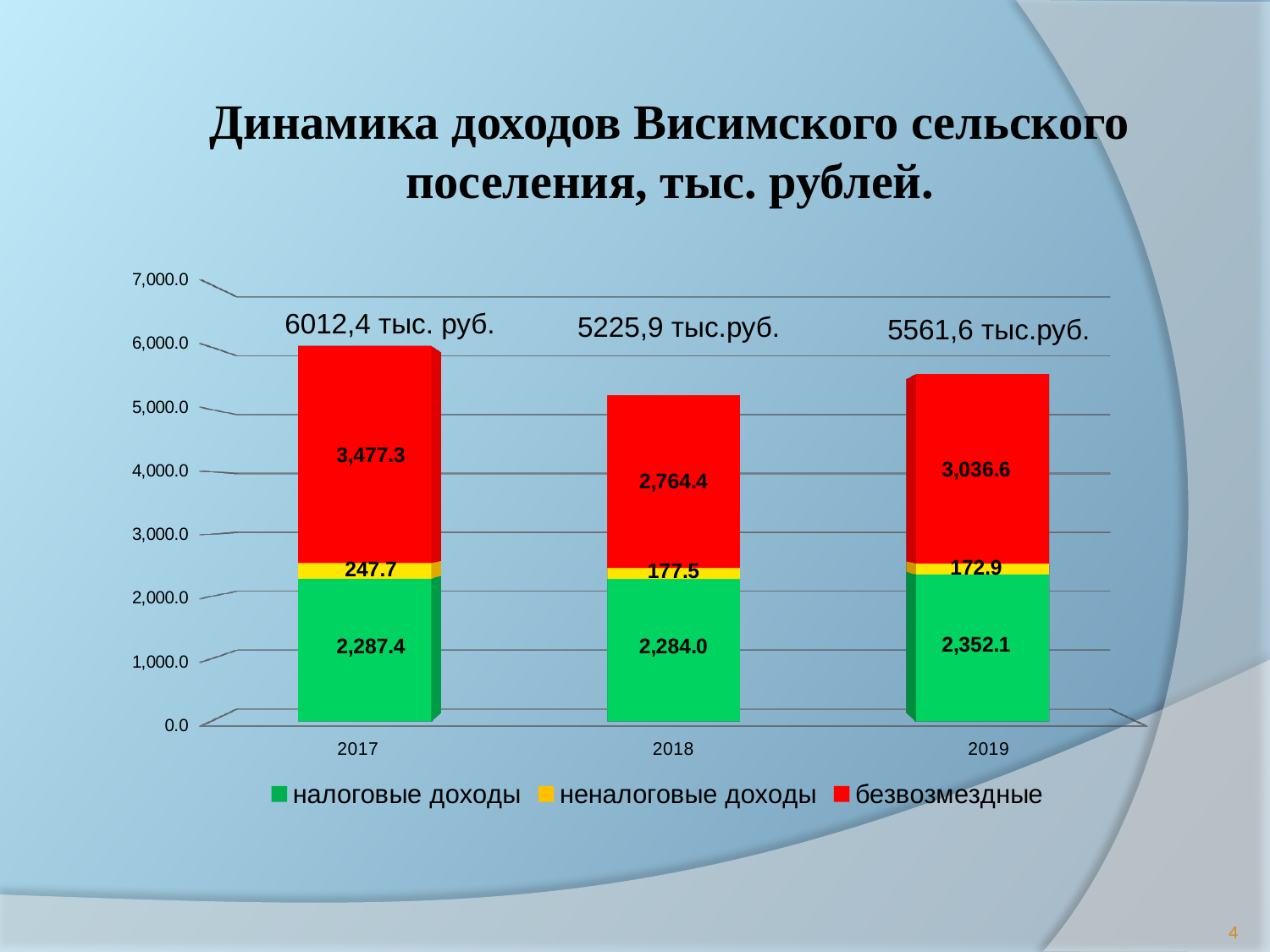
Is the value of неналоговые доходы larger in 2018 or in 2019? 2018 What is the difference between безвозмездные in 2017 and 2019? 440.7 Which series is shown in red in the legend? безвозмездные How many years are shown on the x axis? 3 What is the value of безвозмездные for 2018? 2,764.4 What type of chart is shown on the slide? stacked bar chart What is the total income shown above the bar for 2017? 6012,4 тыс. руб. How many series does the legend list? 3 Which year has the highest value for безвозмездные? 2017 What is the value of налоговые доходы for 2019? 2,352.1 What is the value of неналоговые доходы for 2017? 247.7 Which year has the lowest total income? 2018